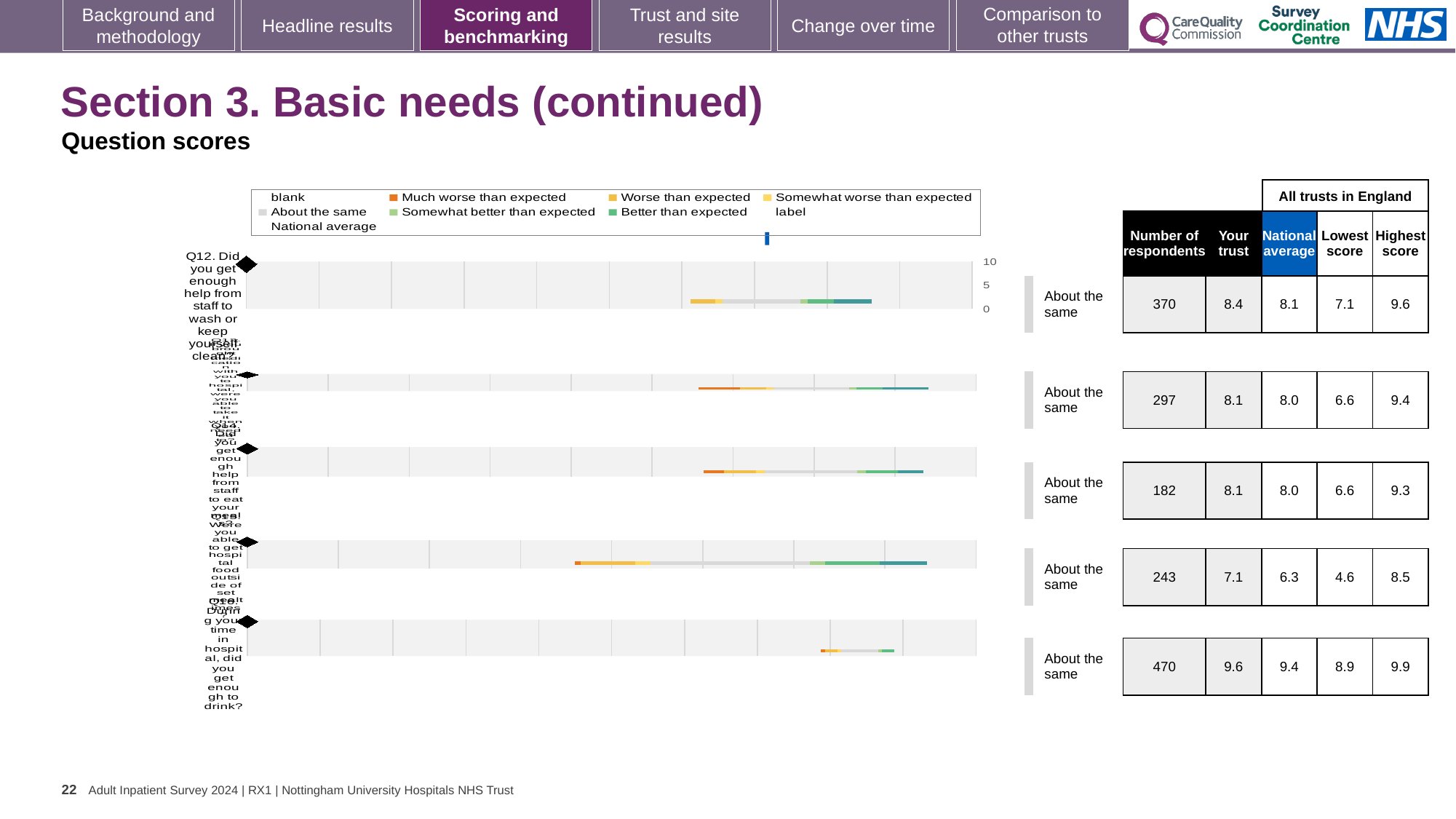
For Q12, which is larger: the 'Your trust' score or the national average? Your trust How many questions (bars) are plotted in the chart? 5 How many respondents answered Q12 (help from staff to wash or keep yourself clean)? 370 What benchmark category is shown for Q12 (help from staff to wash or keep yourself clean)? About the same For Q12, what is the difference between the 'Your trust' score and the national average? 0.3 Is the 'Your trust' score for Q12 greater or less than 5? greater What kind of chart is shown on the slide? bar chart For the question with 243 respondents, what is the difference between the highest score and the lowest score across all trusts in England? 3.9 What is the 'Your trust' score for Q12 (Did you get enough help from staff to wash or keep yourself clean?)? 8.4 What is the national average for Q12 (help from staff to wash or keep yourself clean)? 8.1 What is the highest 'Your trust' score shown in the table for the five questions? 9.6 What is the lowest 'Your trust' score shown in the table for the five questions? 7.1